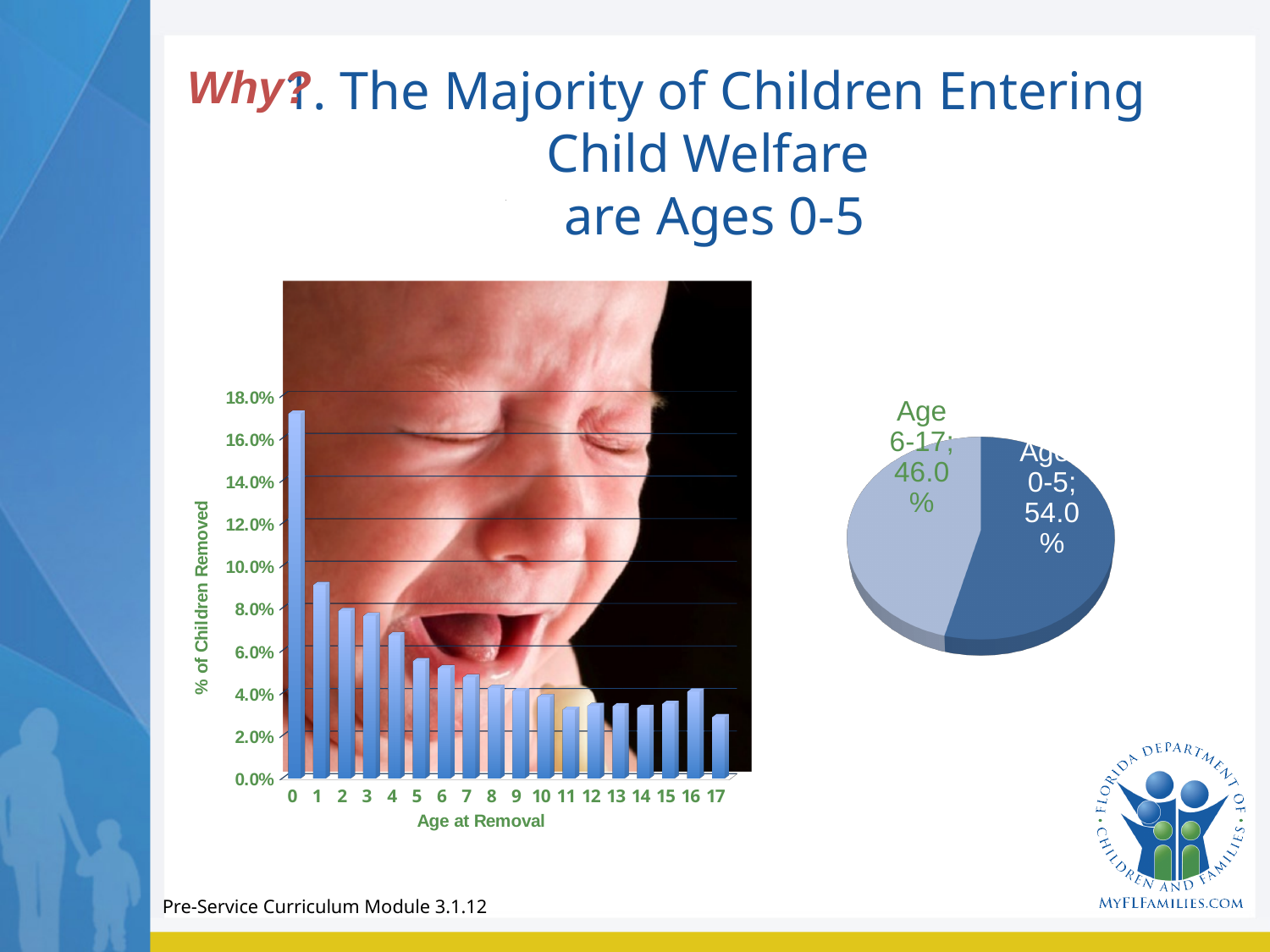
In the bar chart on the left, how many age categories are shown on the x axis? 18 In the bar chart on the left, is the value for age 0 greater or less than 16.0%? greater In the pie chart on the right, which slice is larger, Age 0-5 or Age 6-17? Age 0-5 In the pie chart on the right, what is the difference between the Age 0-5 share and the Age 6-17 share? 8.0% How many slices does the pie chart on the right have? 2 In the pie chart on the right, what share is shown for Age 6-17? 46.0% In the bar chart on the left, do the percentages generally rise or fall as age at removal increases? fall What is the label on the y axis of the bar chart on the left? % of Children Removed In the pie chart on the right, what share is shown for Age 0-5? 54.0% What kind of chart is the chart on the left showing % of Children Removed by Age at Removal? bar chart In the bar chart on the left, which age at removal has the highest percentage of children removed? 0 In the bar chart on the left, is the value for age 1 greater or less than 10.0%? less